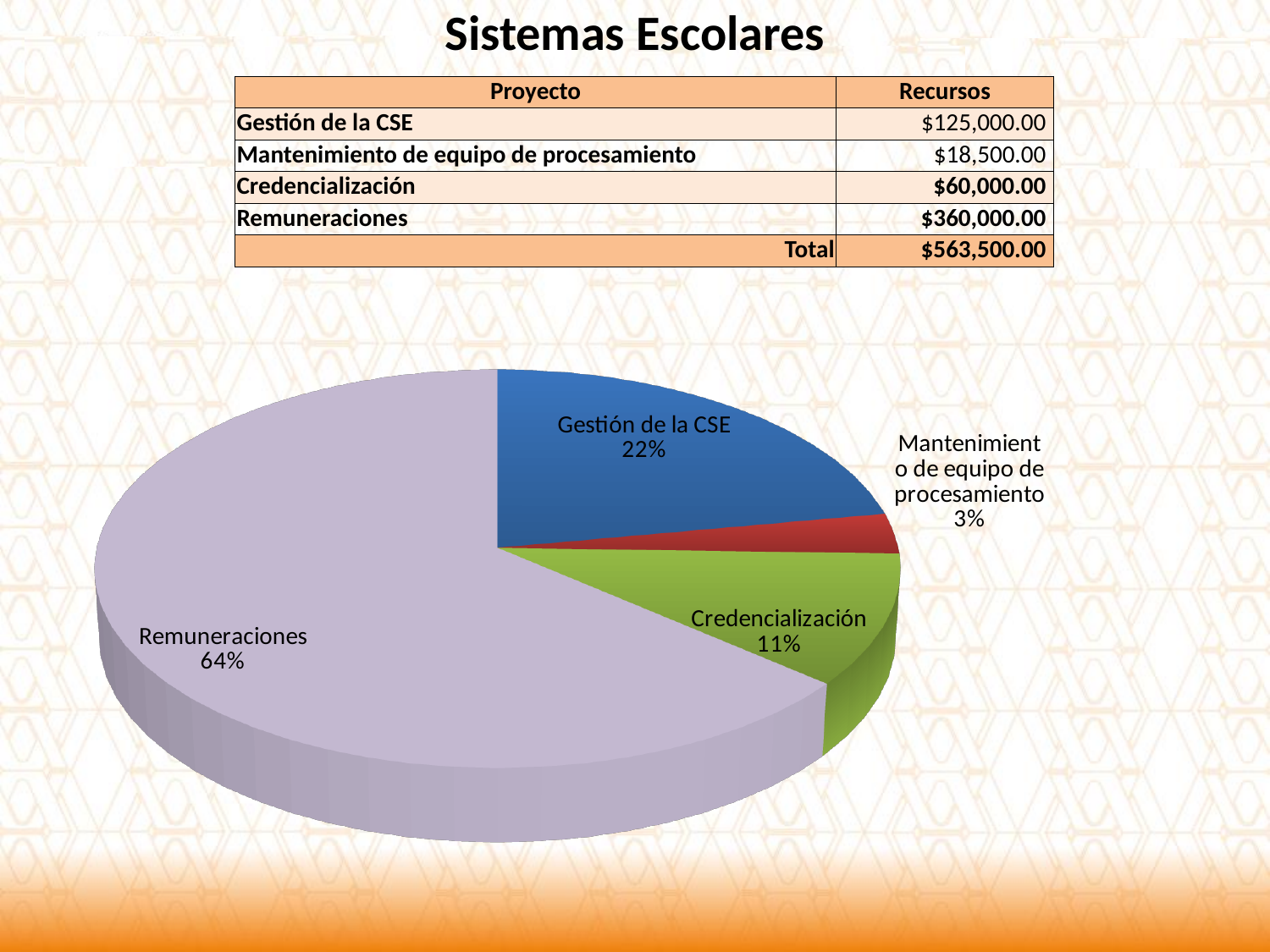
What is the title of the slide containing the pie chart? Sistemas Escolares Which slice of the pie is the largest? Remuneraciones What share of the pie does Remuneraciones represent? 64% What is the difference in percentage points between the Remuneraciones slice and the Gestión de la CSE slice? 42 Which slice of the pie is the smallest? Mantenimiento de equipo de procesamiento Which slice is larger, Gestión de la CSE or Credencialización? Gestión de la CSE What share of the pie does Credencialización represent? 11% What kind of chart is shown on the slide? pie chart What colour is the Remuneraciones slice of the pie? light purple What share of the pie does Mantenimiento de equipo de procesamiento represent? 3% How many slices does the pie chart have? 4